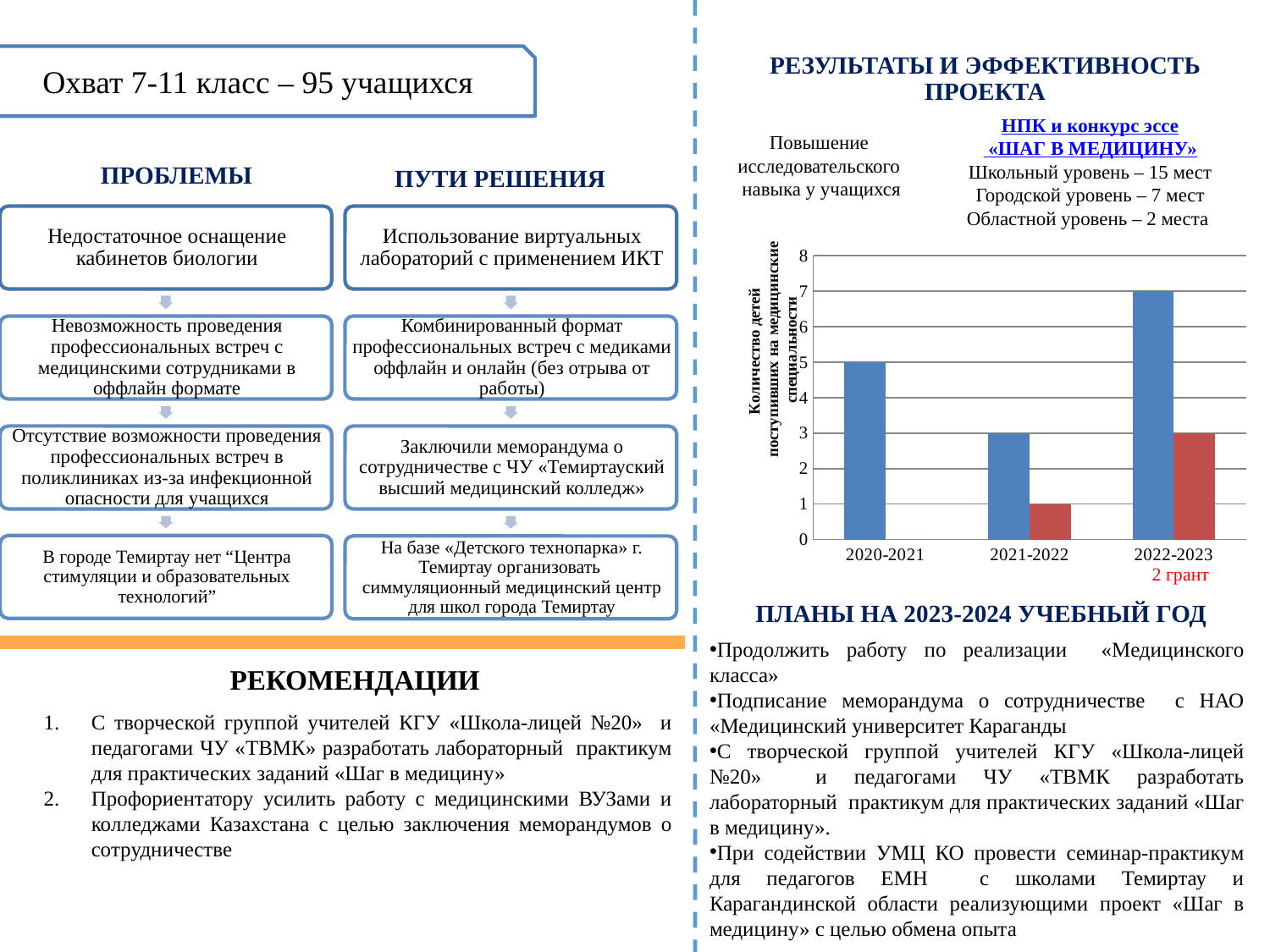
In which academic year is the blue bar highest? 2022-2023 For 2022-2023, which bar is larger, the blue one or the red one? blue What annotation in red text appears below the 2022-2023 category on the chart? 2 грант Do the red bars rise or fall from 2021-2022 to 2022-2023? rise What is the value of the blue bar for 2020-2021? 5 What is the value of the red bar for 2021-2022? 1 What is the difference between the blue bar for 2022-2023 and the blue bar for 2020-2021? 2 What is the value of the blue bar for 2022-2023? 7 How many academic-year categories are shown on the x axis of the chart? 3 What kind of chart is shown on the slide? bar chart In which academic year is the blue bar lowest? 2021-2022 What is the value of the red bar for 2022-2023? 3